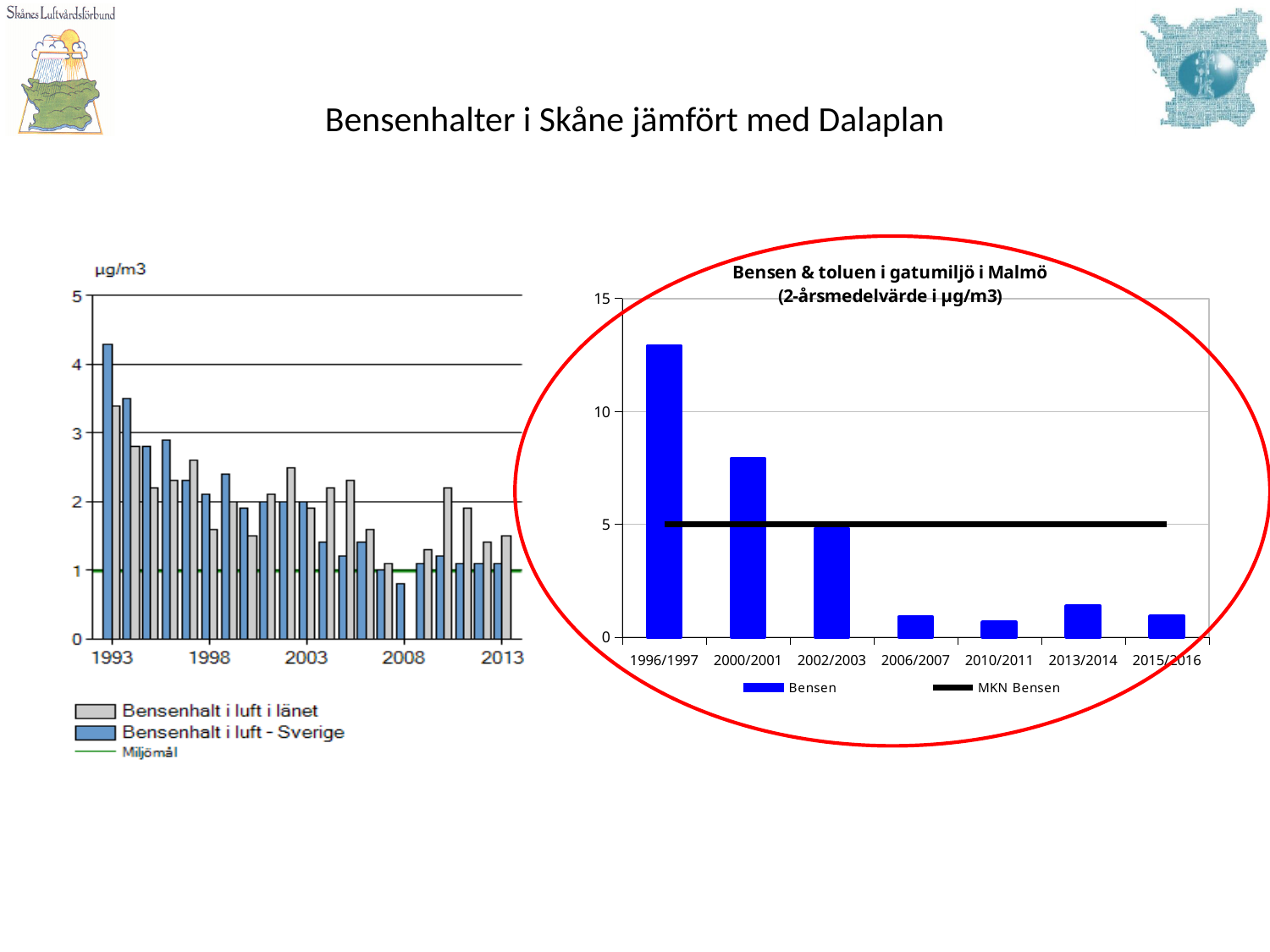
In the chart on the right, do the Bensen values generally rise or fall from 1996/1997 to 2015/2016? fall In the chart on the left, how many entries does the legend list? 3 What kind of chart is the chart on the right, titled 'Bensen & toluen i gatumiljö i Malmö'? bar chart In the chart on the right, what is the name of the series drawn as a black horizontal line? MKN Bensen In the chart on the right, is the Bensen value for 2006/2007 greater or less than 5? less In the chart on the left, is the 'Bensenhalt i luft - Sverige' value for 1993 greater or less than 4? greater In the chart on the right, which is larger, the Bensen value for 2000/2001 or for 2013/2014? 2000/2001 In the chart on the right, is the Bensen value for 2000/2001 greater or less than 10? less In the chart on the right, how many periods are shown on the x axis? 7 In the chart on the right, which period has the highest Bensen value? 1996/1997 In the chart on the right, how many entries does the legend list? 2